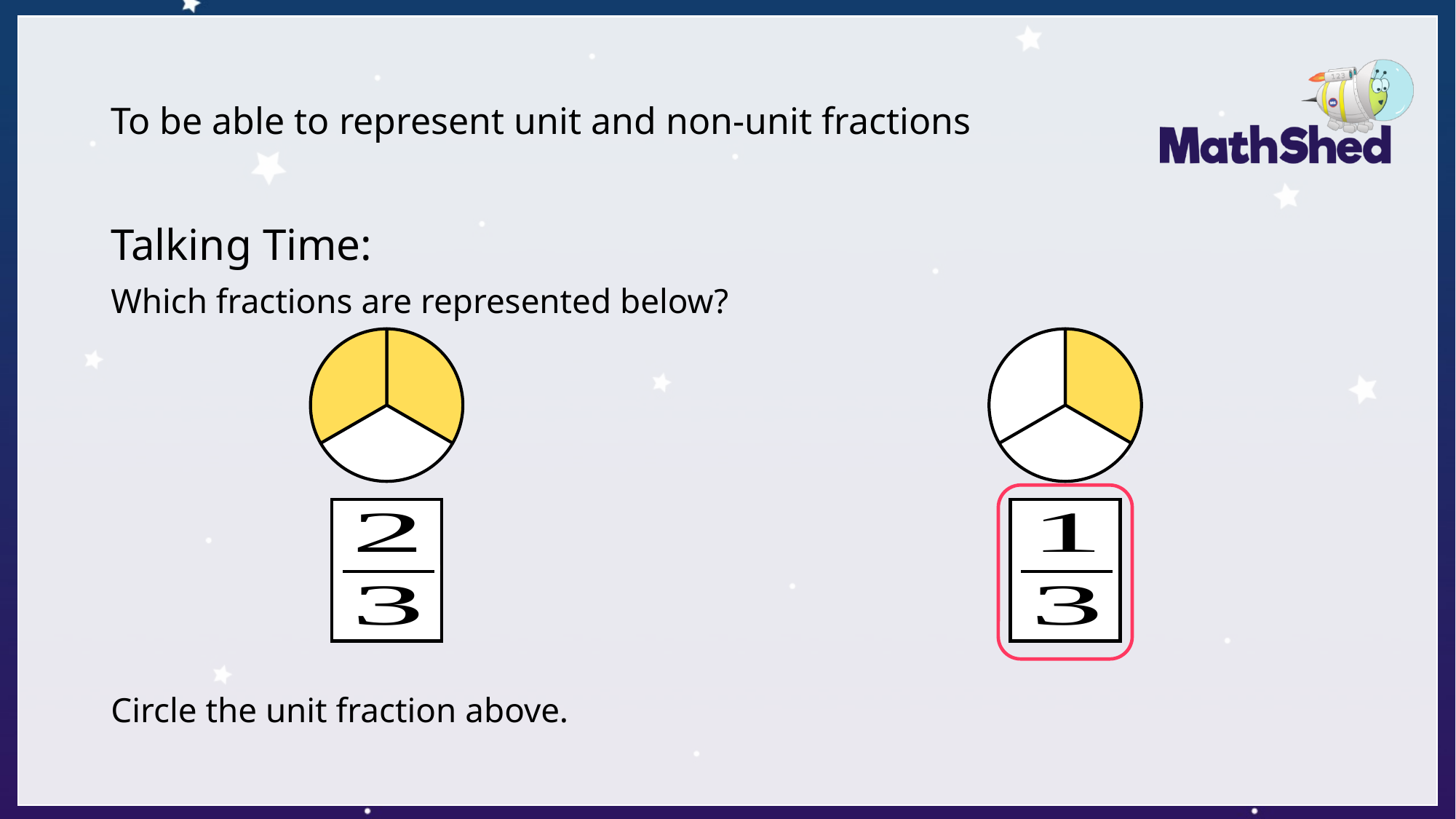
What kind of chart is used to represent the fractions on the slide? pie chart Which circle has the larger shaded share, the left or the right? left How many sections of the right circle are shaded yellow? 1 How many sections of the left circle are shaded yellow? 2 What is the difference between the shaded shares of the left and right circles? 1/3 What fraction is printed below the right circle? 1/3 What fraction is printed below the left circle? 2/3 What share of the right circle is shaded yellow? 1/3 Which fraction on the slide is circled in pink? 1/3 How many equal parts is the right circle divided into? 3 What share of the left circle is shaded yellow? 2/3